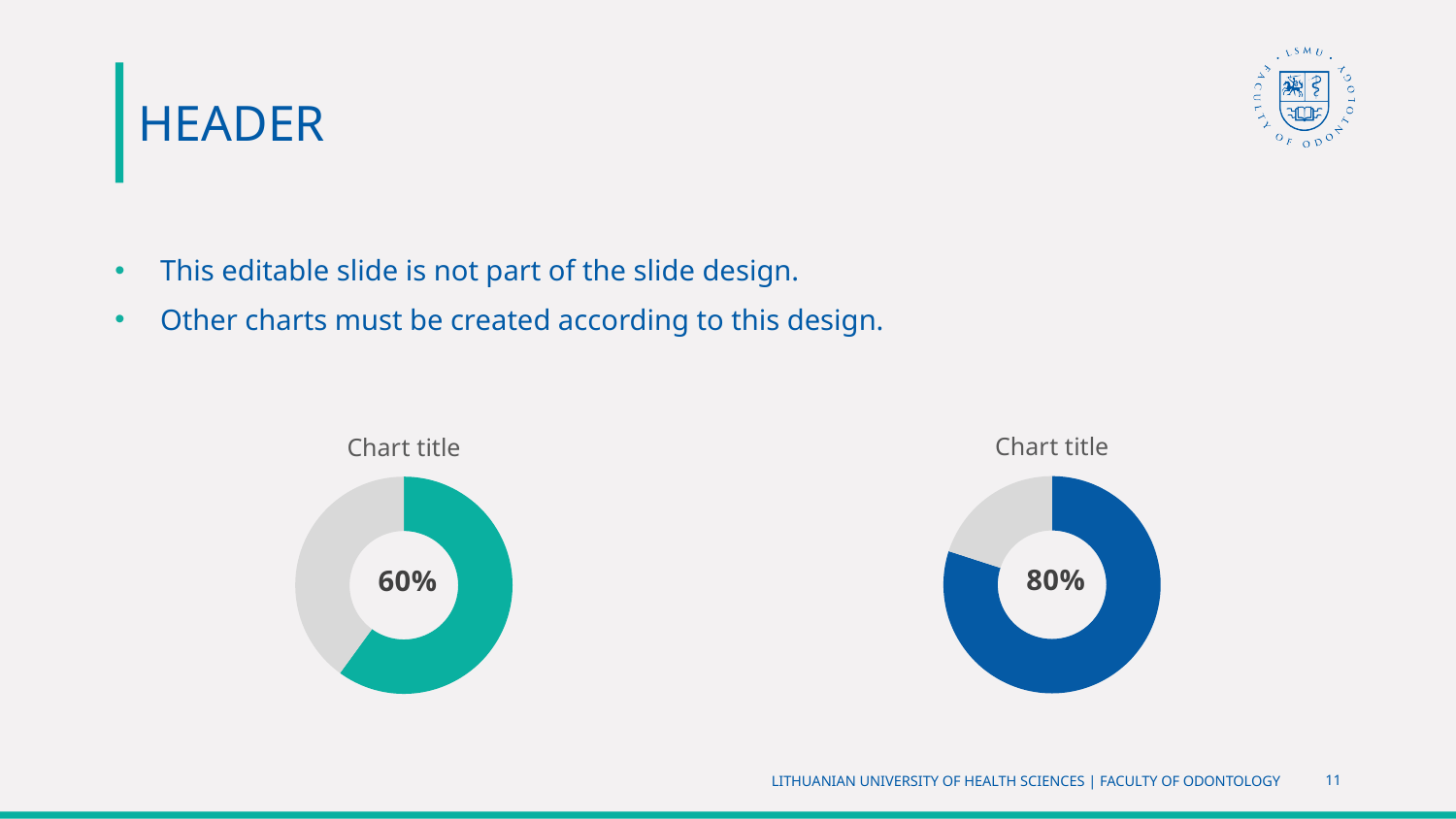
In the left chart, what share of the ring is filled by the teal segment? 60% How many donut charts are on the slide? 2 What value is shown in the centre of the right chart? 80% In the right chart, what share of the ring is filled by the blue segment? 80% What colour is the filled segment of the right chart? Blue What is the title shown above the left chart? Chart title Which chart shows the larger percentage, the left chart or the right chart? The right chart How many segments does the left chart's ring have? 2 What value is shown in the centre of the left chart? 60% What kind of chart is the right chart? Donut chart What is the difference between the percentage shown in the right chart and the percentage shown in the left chart? 20% What kind of chart is the left chart? Donut chart